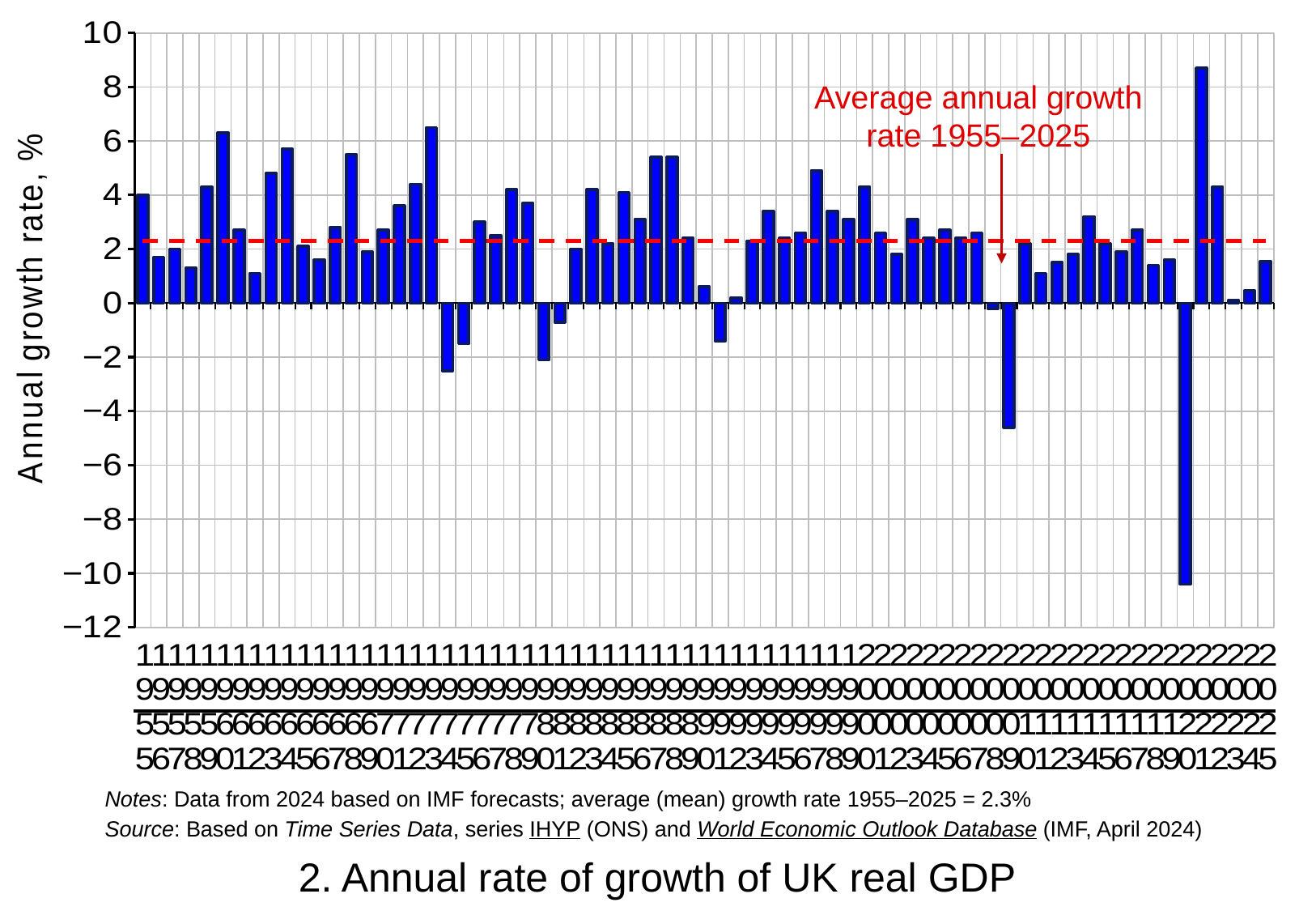
Which year has the highest annual growth rate in the chart? 2021 Is the value for 1973 greater or less than 6? greater Is the value for 2020 greater or less than -8? less What is the average (mean) annual growth rate for 1955–2025 stated on the slide? 2.3% Which year has the lowest annual growth rate in the chart? 2020 Which year has the larger growth rate, 2021 or 1973? 2021 Is the value for 1988 greater or less than 4? greater Which year has the lower growth rate, 2009 or 2020? 2020 What kind of chart is shown on the slide? Bar chart What does the red dashed horizontal line on the chart represent? Average annual growth rate 1955–2025